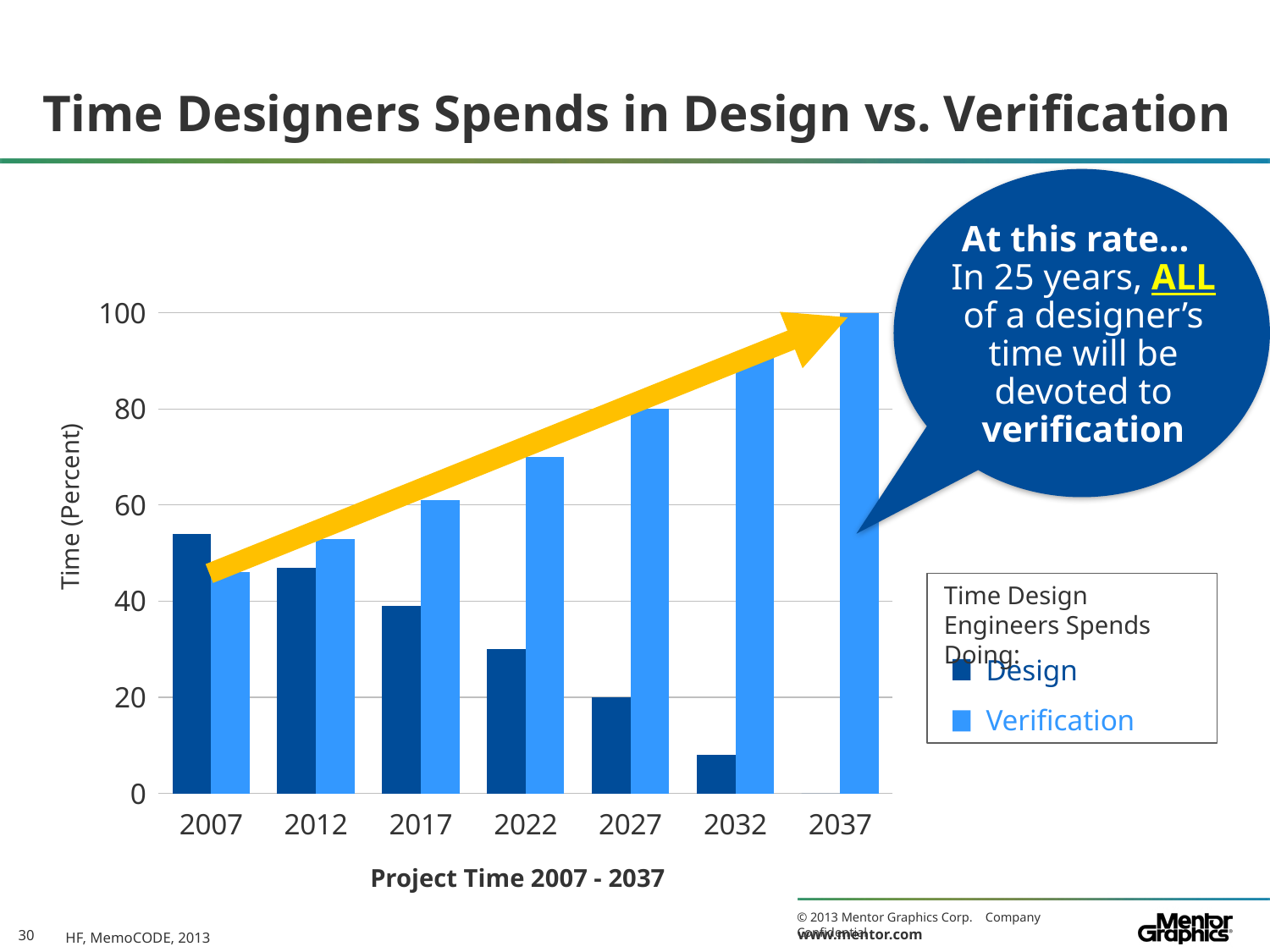
Is the Design value for 2032 greater or less than 20? less What is the title of the y axis? Time (Percent) What kind of chart is shown on the slide? bar chart Is the Design value for 2007 greater or less than 40? greater In which year is the Verification bar highest? 2037 How many years are shown on the x axis? 7 What is the Verification value for 2037? 100 In which year is the Design bar lowest? 2037 Do the Verification values rise or fall from 2007 to 2037? rise In 2007, which is larger, the Design bar or the Verification bar? Design Is the Verification value for 2032 greater or less than 80? greater How many series does the legend list? 2